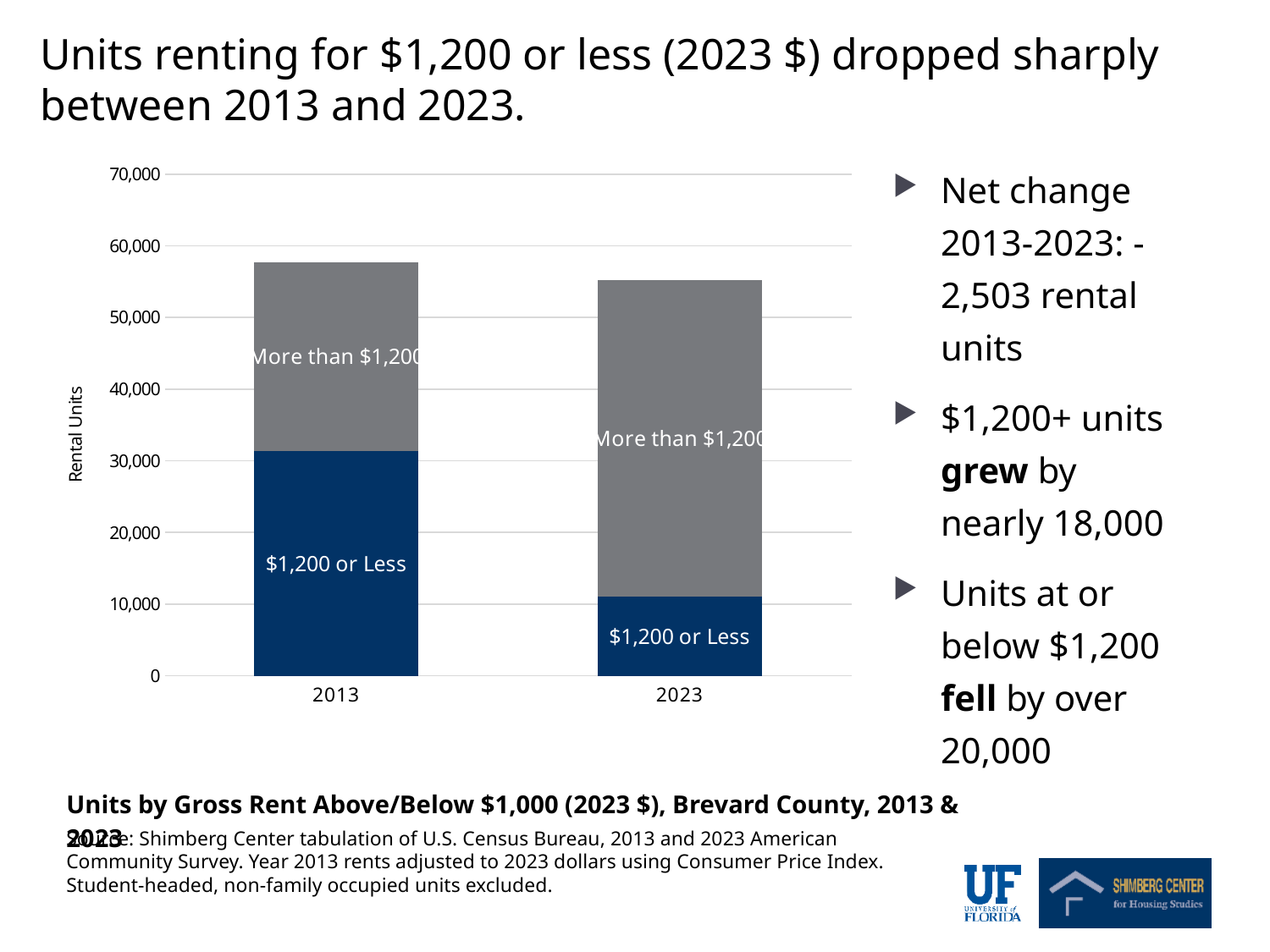
What kind of chart is shown on the slide? Stacked bar chart Is the total height of the 2023 bar greater or less than 50,000? greater Does the "$1,200 or Less" segment rise or fall from 2013 to 2023? Fall Which year has the larger "More than $1,200" segment, 2013 or 2023? 2023 Is the total height of the 2013 bar greater or less than 60,000? less Which year has the larger "$1,200 or Less" segment, 2013 or 2023? 2013 What is the label on the vertical axis of the chart? Rental Units How many rent series are stacked in each bar of the chart? 2 Is the value for "$1,200 or Less" in 2013 greater or less than 20,000? greater How many years (categories) are shown on the x axis of the chart? 2 Which two rent categories are labelled inside the bars? $1,200 or Less and More than $1,200